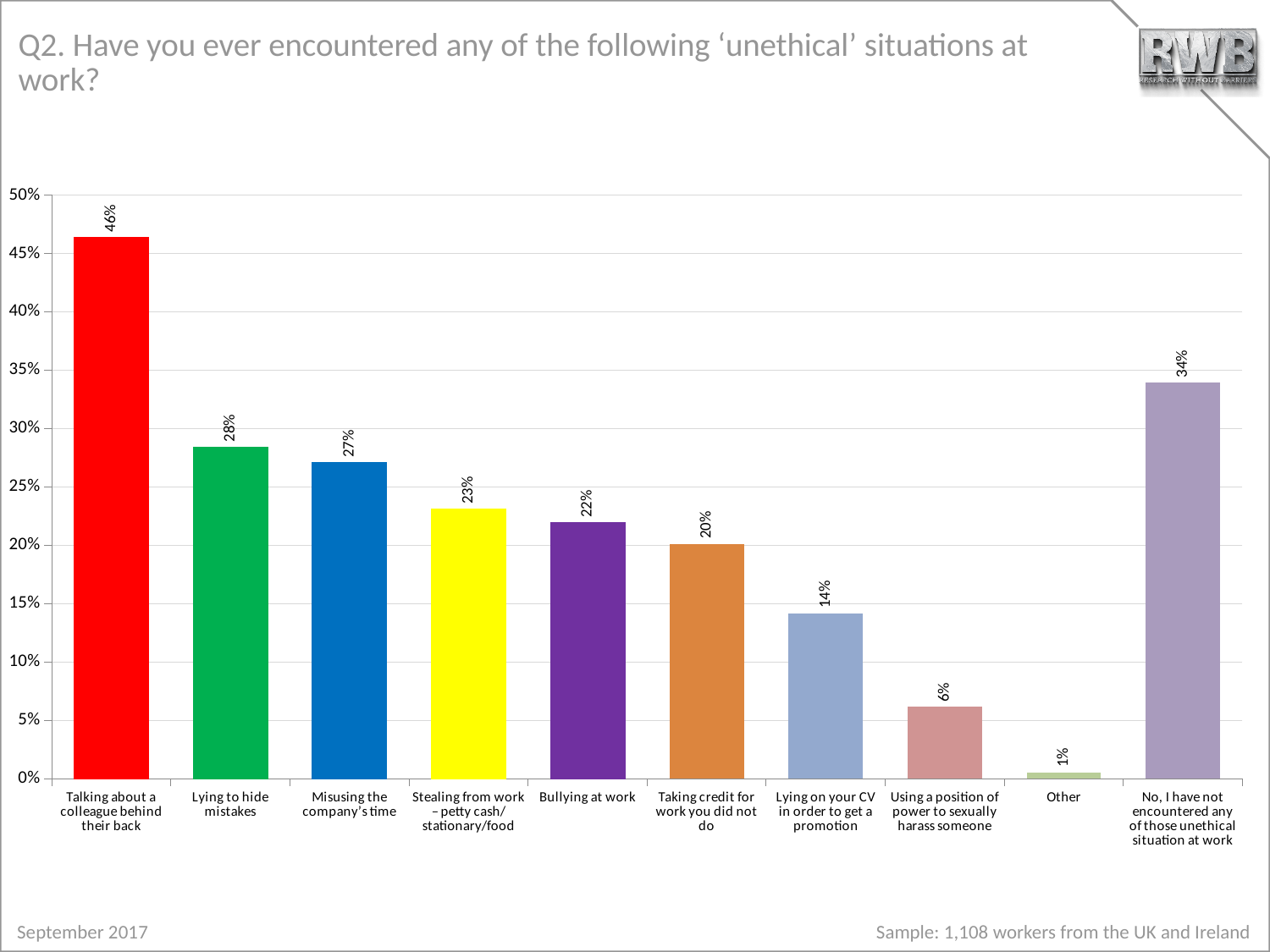
What kind of chart is shown on the slide? Bar chart Which is larger: 'Taking credit for work you did not do' or 'Lying on your CV in order to get a promotion'? Taking credit for work you did not do How many categories are shown on the chart? 10 What colour is the bar for 'Stealing from work – petty cash/stationary/food'? Yellow What is the difference between 'Talking about a colleague behind their back' and 'No, I have not encountered any of those unethical situation at work'? 12% What is the difference between 'Lying to hide mistakes' and 'Misusing the company's time'? 1% Which category has the highest value? Talking about a colleague behind their back Which category has the lowest value? Other What percentage of respondents have encountered talking about a colleague behind their back? 46% What is the value for 'Bullying at work'? 22% What percentage of respondents said they have not encountered any of those unethical situations at work? 34% Is the value for 'Using a position of power to sexually harass someone' greater or less than 10%? less